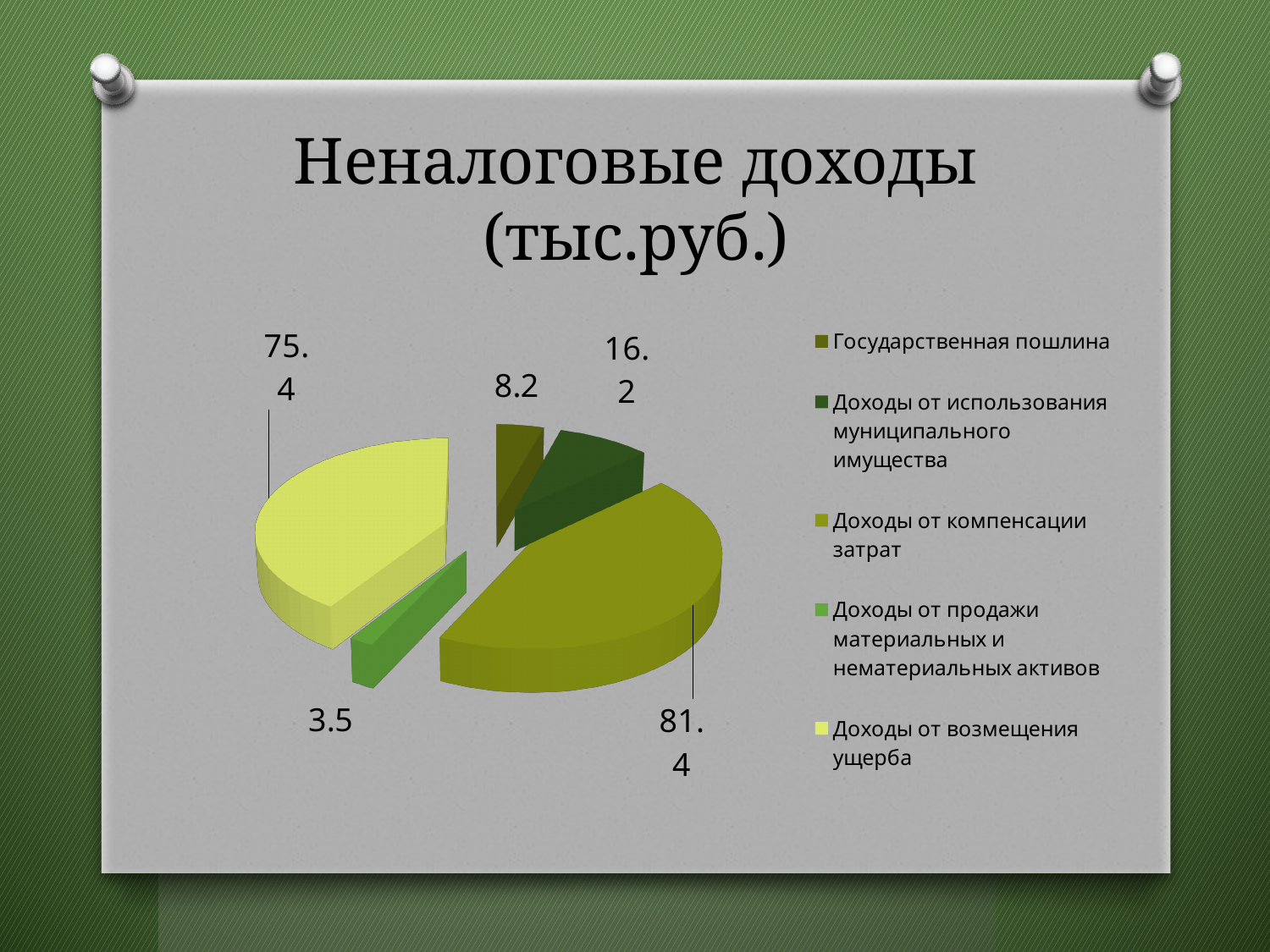
What is the value for Доходы от возмещения ущерба? 75.4 What is the value for Доходы от компенсации затрат? 81.4 How many entries does the legend list? 5 What is the title of the chart? Неналоговые доходы (тыс.руб.) How many slices does the pie chart have? 5 What is the difference between Доходы от использования муниципального имущества and Государственная пошлина? 8.0 Which category has the smallest value? Доходы от продажи материальных и нематериальных активов Which is larger, Доходы от компенсации затрат or Доходы от возмещения ущерба? Доходы от компенсации затрат Which category has the largest value? Доходы от компенсации затрат What type of chart is shown on the slide? pie chart What is the value for Доходы от продажи материальных и нематериальных активов? 3.5 What is the value for Государственная пошлина? 8.2